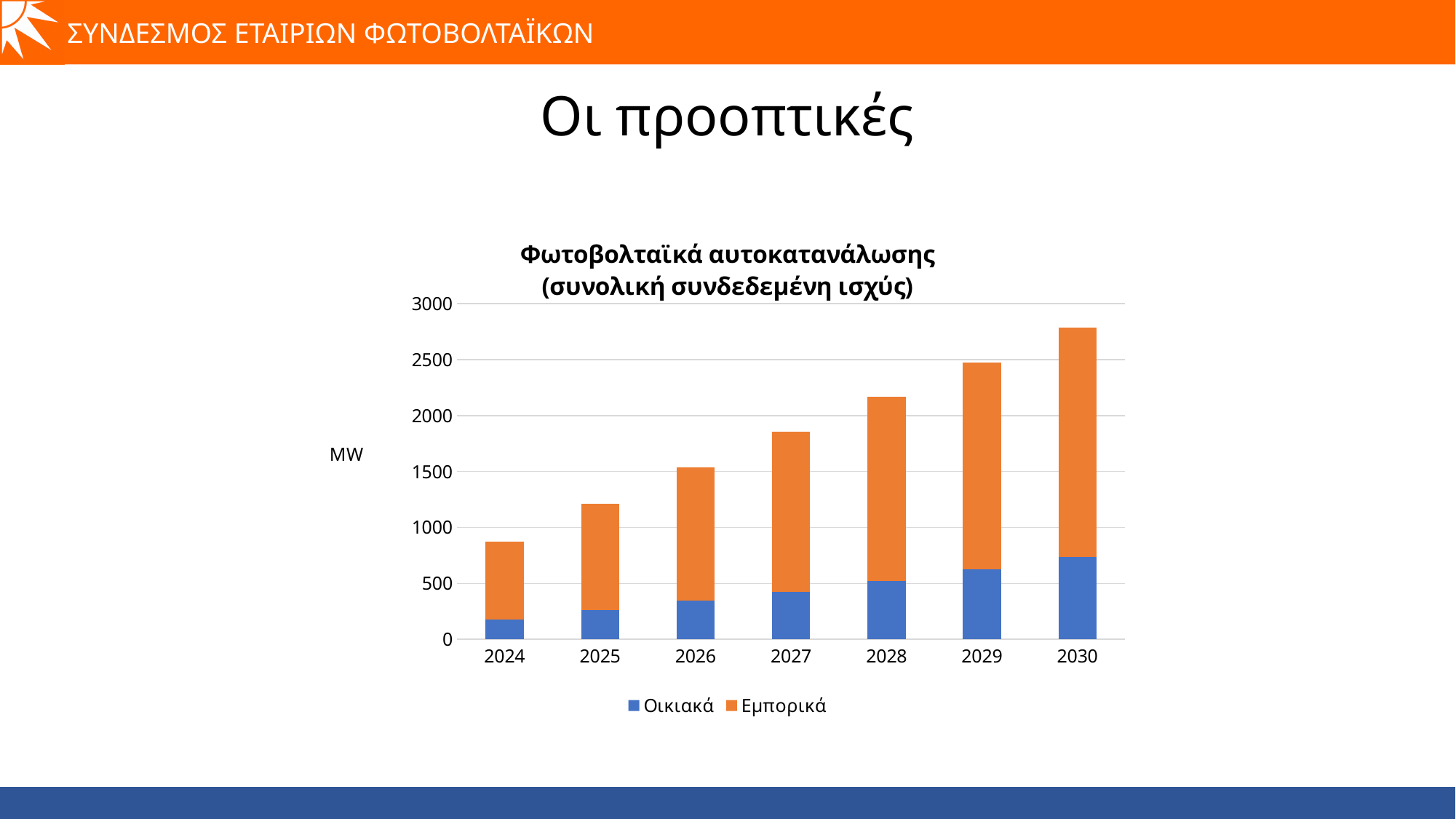
What kind of chart is shown on the slide? stacked bar chart Which year has the shortest total bar in the chart? 2024 Is the total value for 2024 greater or less than 1000? less How many years are shown on the x axis of the chart? 7 Which year has the tallest total bar in the chart? 2030 In 2030, which series has the larger value, Οικιακά or Εμπορικά? Εμπορικά Is the total value for 2028 greater or less than 2000? greater Is the total value for 2030 greater or less than 2500? greater How many series does the chart's legend list? 2 Do the total bar heights rise or fall from 2024 to 2030? rise What unit is shown on the vertical axis of the chart? MW